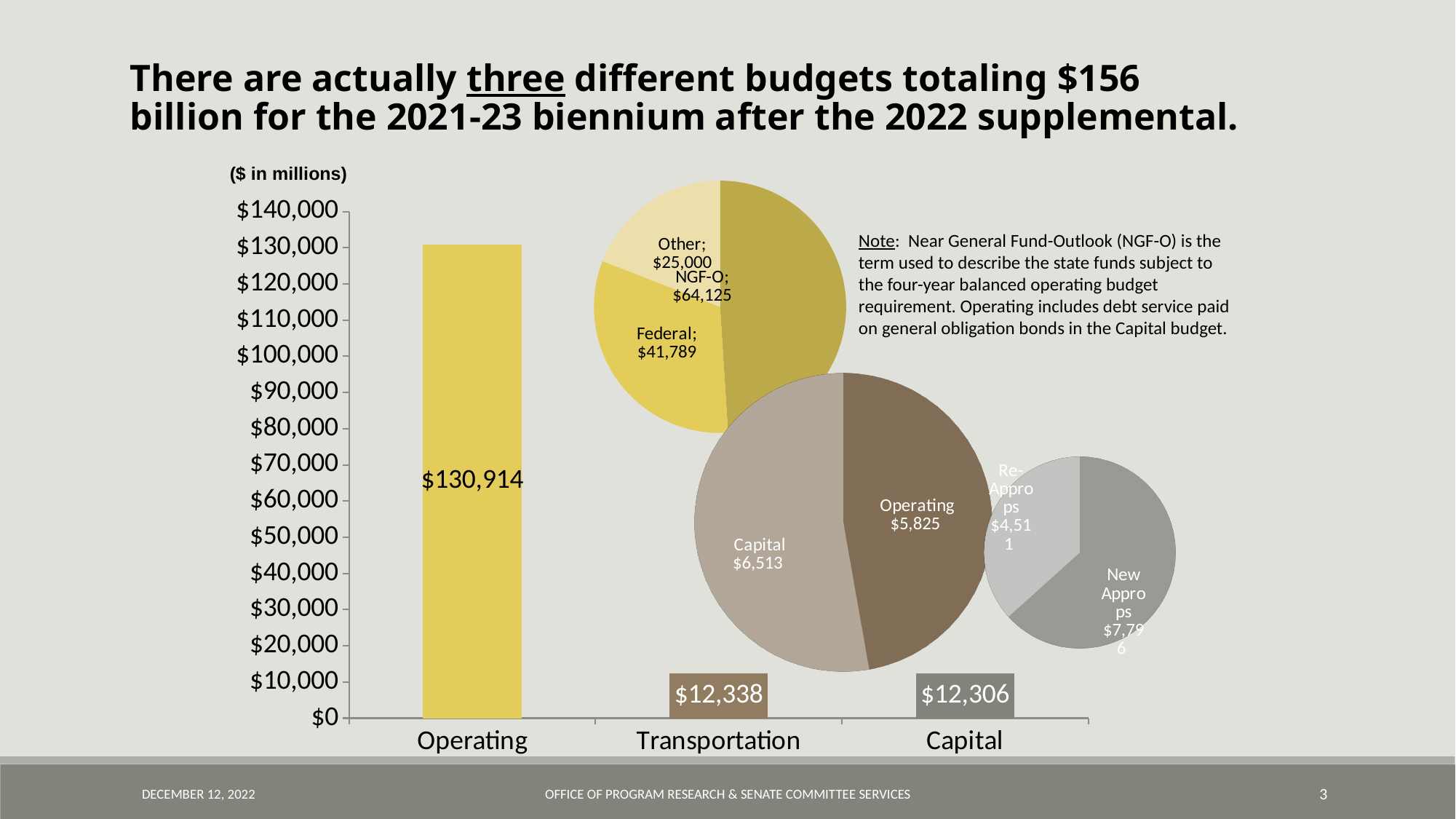
In the bar chart, which category has the highest value? Operating In the yellow pie chart at the top, what is the value for Federal? $41,789 In the bar chart, what is the difference between the Transportation and Capital values? $32 In the bar chart, what is the value for Operating? $130,914 In the bar chart, what is the value for Transportation? $12,338 In the gray pie chart on the right, which is larger, Re-Approps or New Approps? New Approps What kind of chart is the large chart with the $140,000 axis? Bar chart In the bar chart, which category has the lowest value? Capital In the yellow pie chart at the top, which slice is the largest? NGF-O In the bar chart, what is the value for Capital? $12,306 In the brown pie chart in the middle, what is the value for Capital? $6,513 How many categories are shown on the x axis of the bar chart? 3